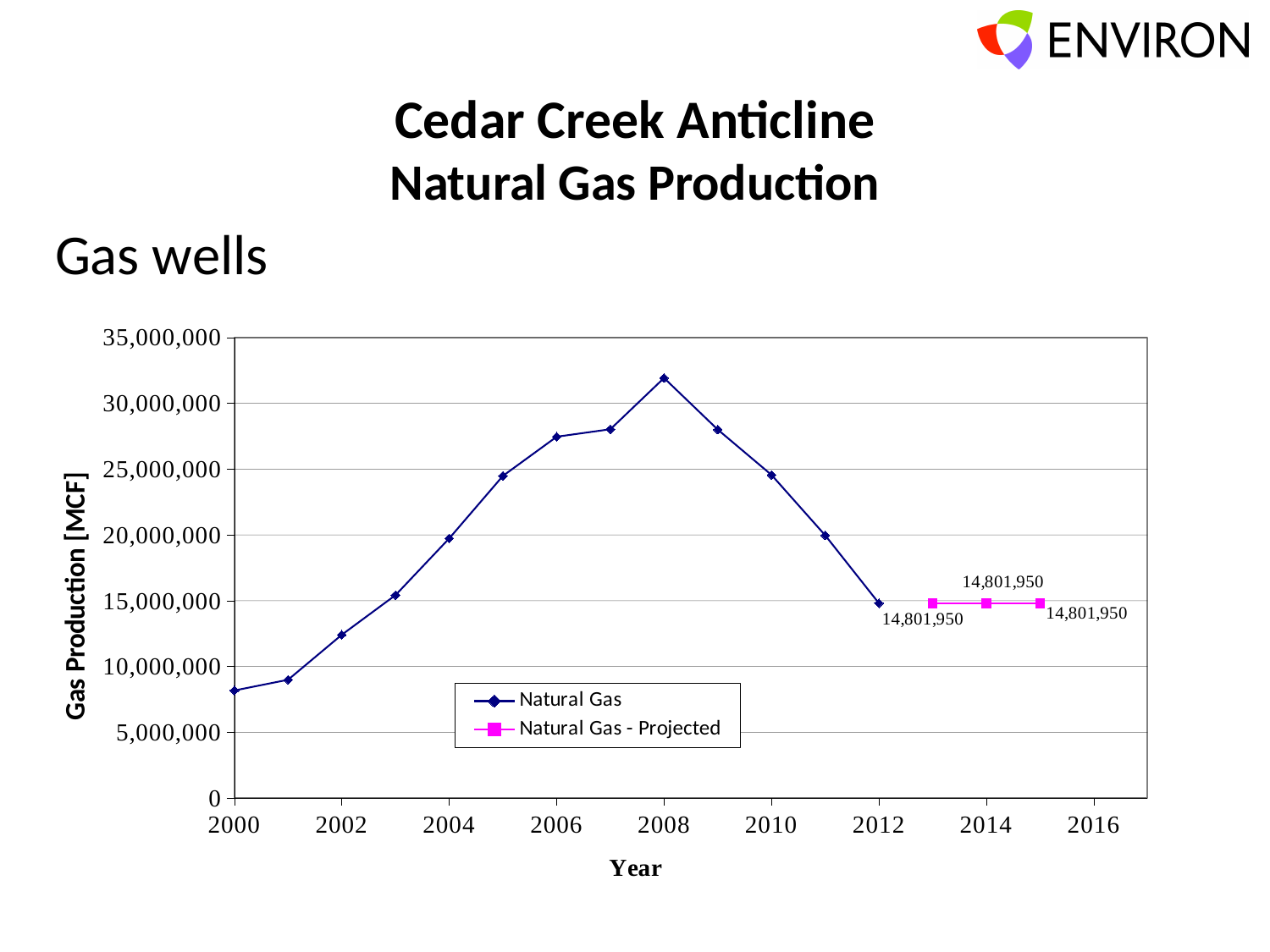
How many data points does the Natural Gas - Projected series have? 3 Does the Natural Gas series rise or fall between 2008 and 2012? Fall What is the projected natural gas production value shown for 2014? 14,801,950 Is the Natural Gas value for 2008 greater or less than 30,000,000? greater In which year does the Natural Gas series reach its highest value? 2008 Which year has the larger Natural Gas value, 2003 or 2009? 2009 Is the Natural Gas value for 2011 greater or less than 25,000,000? less What value is labelled for the Natural Gas - Projected series in 2015? 14,801,950 What is the title of the vertical axis? Gas Production [MCF] What kind of chart is shown on the slide? Line chart Is the Natural Gas value for 2000 greater or less than 10,000,000? less How many series does the legend list? 2